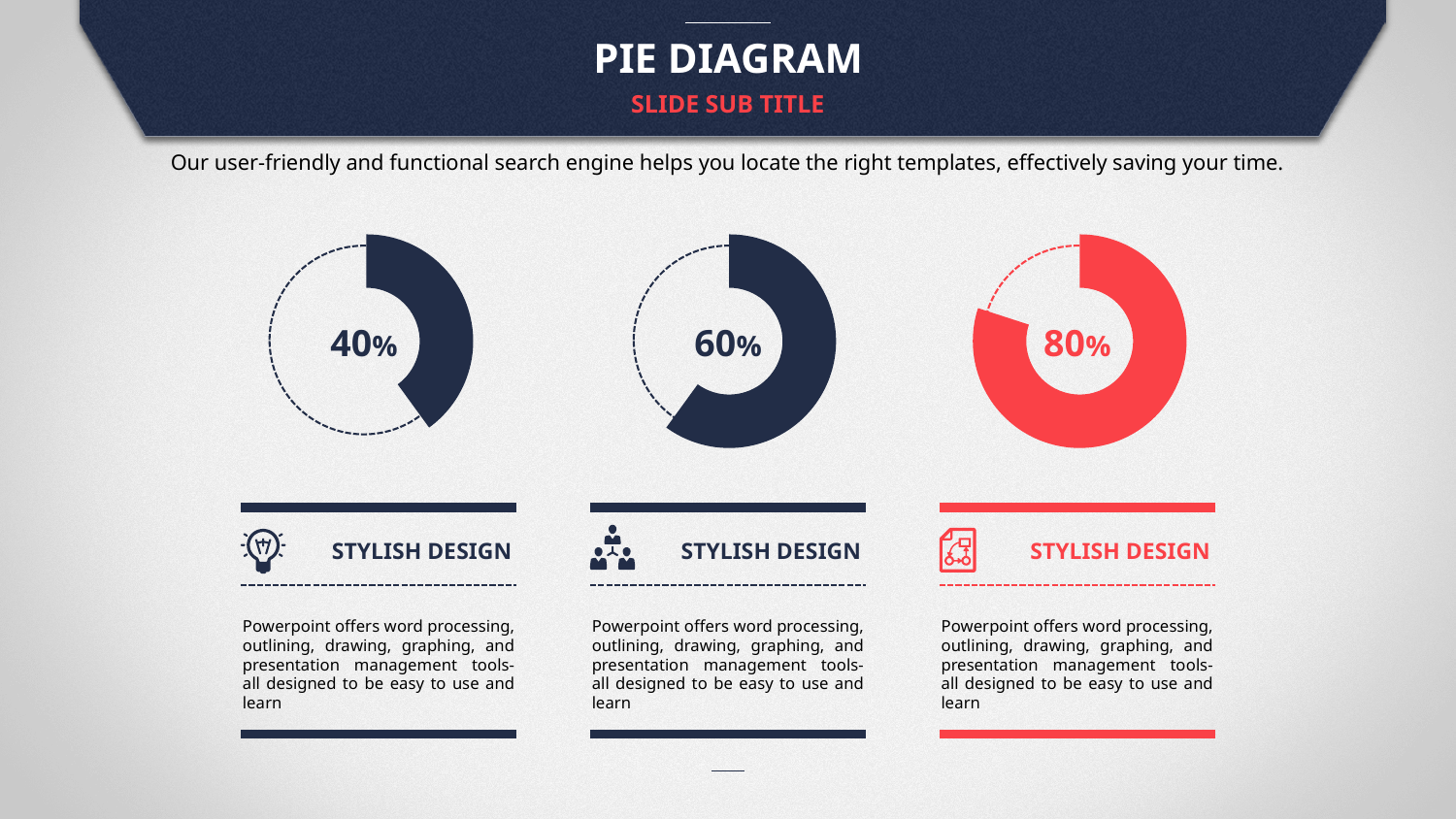
What colour is the filled portion of the right donut chart? Red Which of the three donut charts shows the lowest percentage? The left chart (40%) What kind of chart is used to display the percentages on this slide? Donut (pie) chart Is the value in the middle donut chart larger or smaller than the value in the right donut chart? Smaller What value is shown in the right donut chart? 80% What is the difference between the value in the middle donut chart and the value in the left donut chart? 20% What value is shown in the left donut chart? 40% How many donut charts are shown on the slide? 3 Do the percentages increase or decrease from the left chart to the right chart? Increase Which of the three donut charts shows the highest percentage? The right chart (80%) What value is shown in the middle donut chart? 60% What is the difference between the value in the right donut chart and the value in the left donut chart? 40%